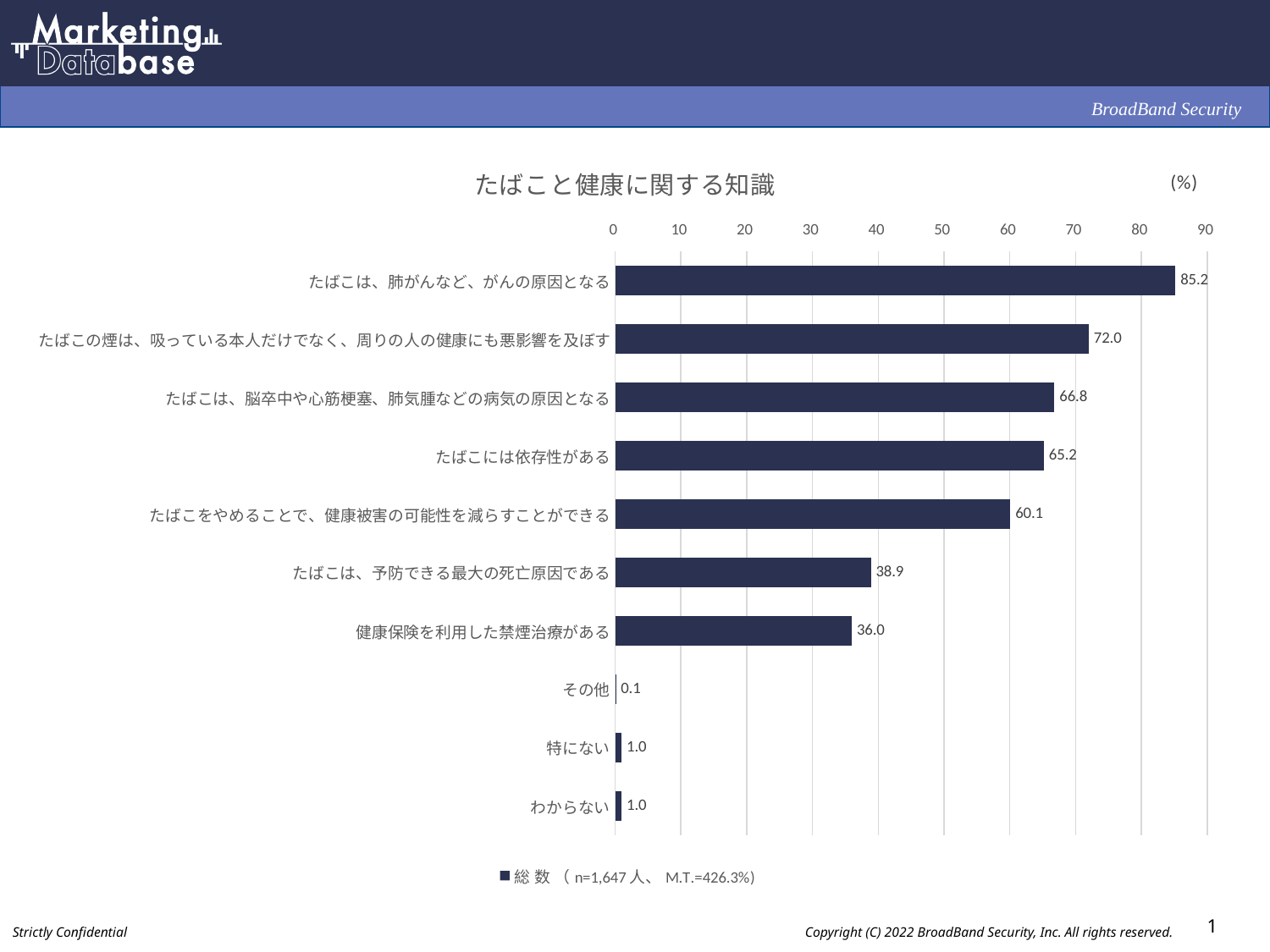
What is the value for 「たばこをやめることで、健康被害の可能性を減らすことができる」? 60.1 Which category has the lowest value? その他 What is the value for 「たばこは、肺がんなど、がんの原因となる」? 85.2 What kind of chart is shown on the slide? bar chart How many categories are shown in the chart? 10 What is the difference between the values for 「たばこの煙は、吸っている本人だけでなく、周りの人の健康にも悪影響を及ぼす」 and 「たばこは、脳卒中や心筋梗塞、肺気腫などの病気の原因となる」? 5.2 What is the title of the chart? たばこと健康に関する知識 Which is larger, the value for 「たばこは、予防できる最大の死亡原因である」 or the value for 「健康保険を利用した禁煙治療がある」? たばこは、予防できる最大の死亡原因である What is the value for 「健康保険を利用した禁煙治療がある」? 36.0 Which category has the highest value? たばこは、肺がんなど、がんの原因となる Is the value for 「たばこには依存性がある」 greater or less than 60? greater How many series does the legend list? 1